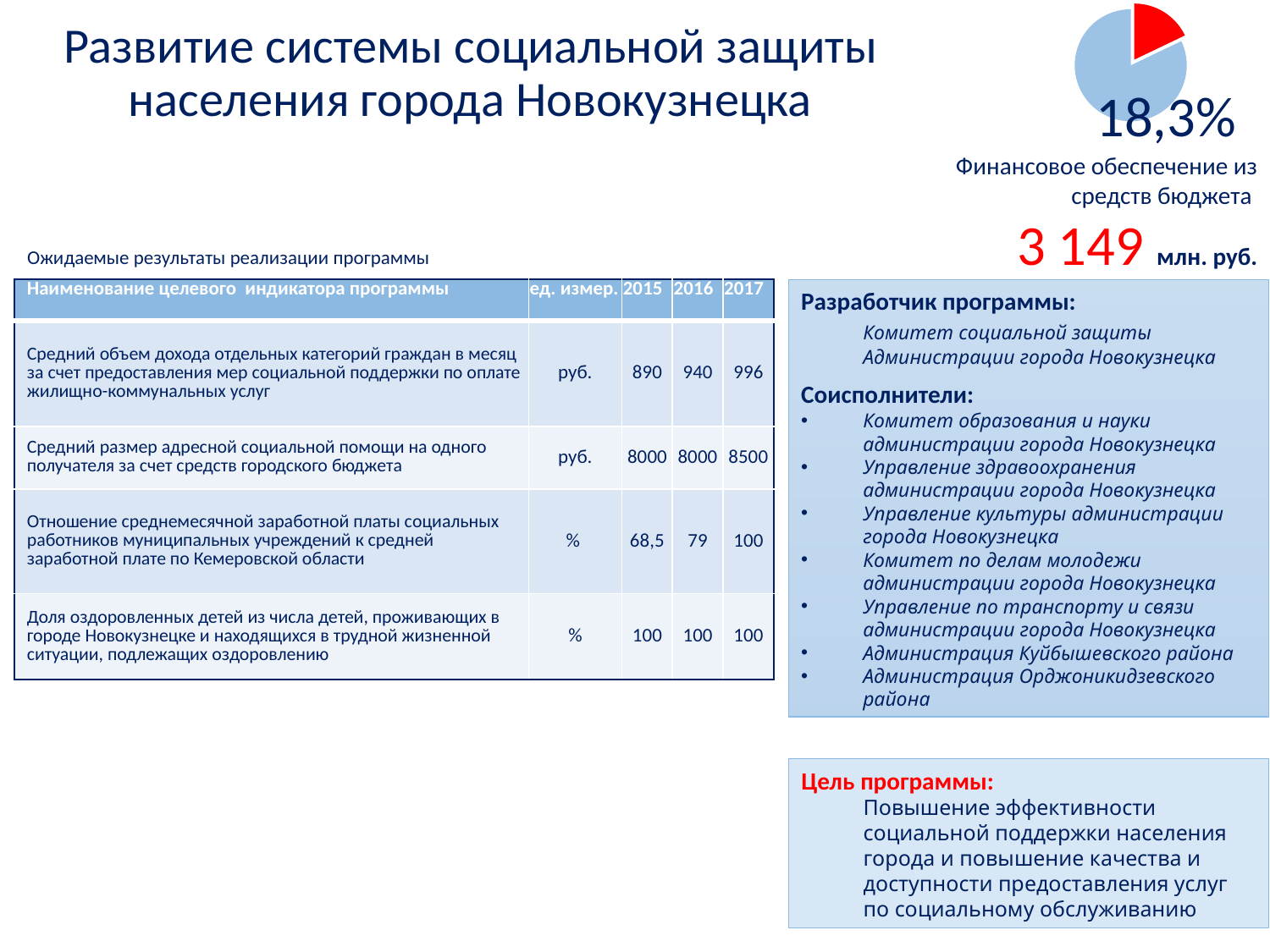
In the pie chart, which slice is larger, the red one or the light blue one? the light blue one How many slices does the pie chart in the top right have? 2 Which slice of the pie chart is the smallest? the red slice (18,3%) What percentage is printed next to the pie chart in the top right? 18,3% What caption appears directly below the pie chart? Финансовое обеспечение из средств бюджета What kind of chart is shown in the top right corner of the slide? pie chart Is the share of the red slice in the pie chart greater or less than 50%? less What colour is the slice of the pie chart labelled 18,3%? red